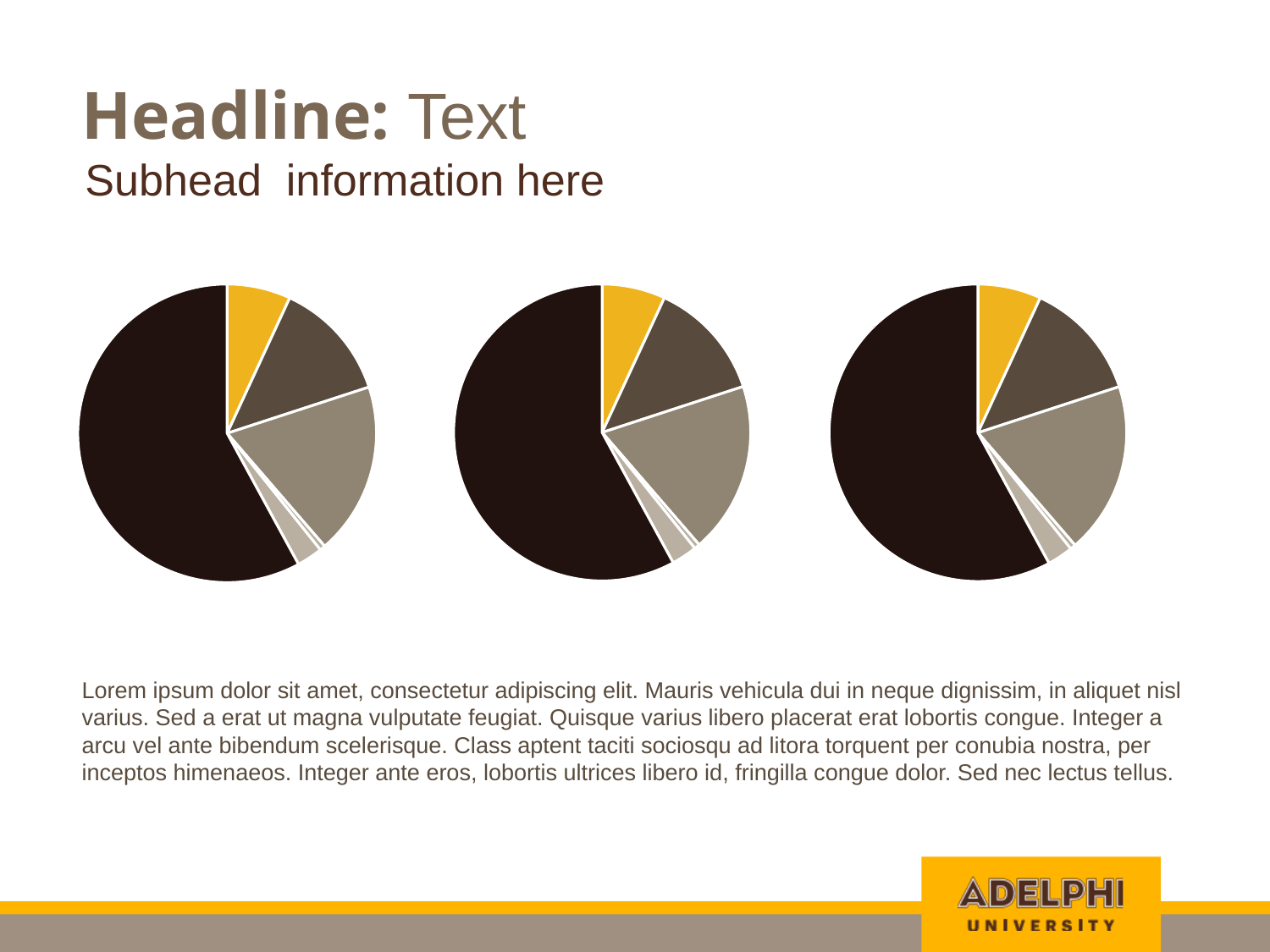
In the middle pie chart, which colour slice is the largest? dark brown In the right pie chart, which is larger, the yellow slice or the tan slice? tan What kind of chart is shown on the left of the slide? pie chart Does the left pie chart show a legend? No In the left pie chart, which is larger, the yellow slice or the dark brown slice? dark brown In the right pie chart, which colour slice is the largest? dark brown How many pie charts are shown on the slide? 3 In the left pie chart, which colour slice is the largest? dark brown